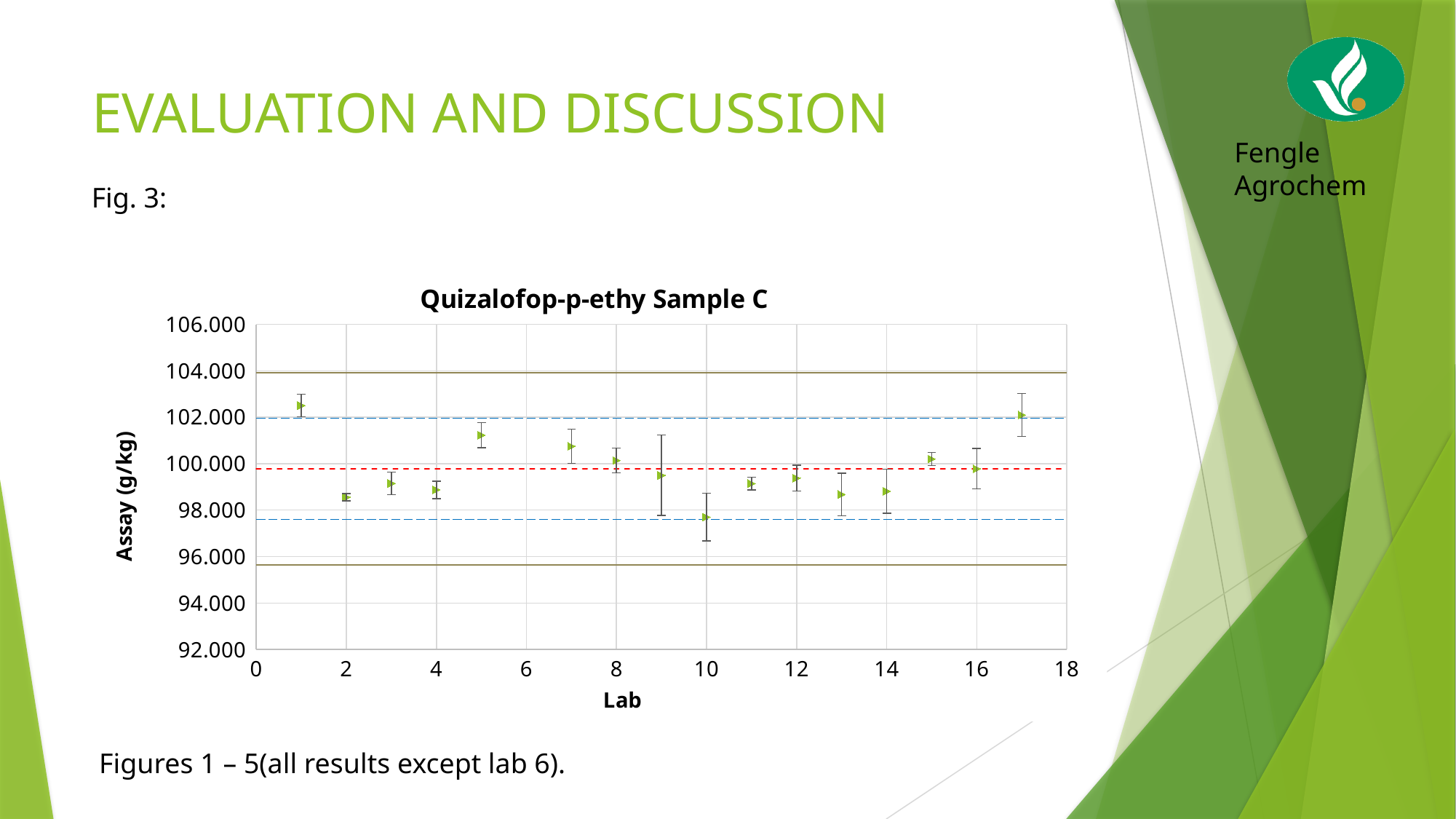
Is the assay value for lab 5 greater or less than 100.000? greater Is the assay value for lab 10 greater or less than 98.000? less Is the assay value for lab 1 greater or less than 102.000? greater Which has the larger assay value, lab 7 or lab 13? Lab 7 Which lab has the lowest assay value? Lab 10 Which has the larger assay value, lab 5 or lab 2? Lab 5 What is the label of the y axis? Assay (g/kg) What is the title of the chart? Quizalofop-p-ethy Sample C How many labs have a data point plotted on the chart? 16 Which lab has the highest assay value? Lab 1 What kind of chart is shown on the slide? scatter chart